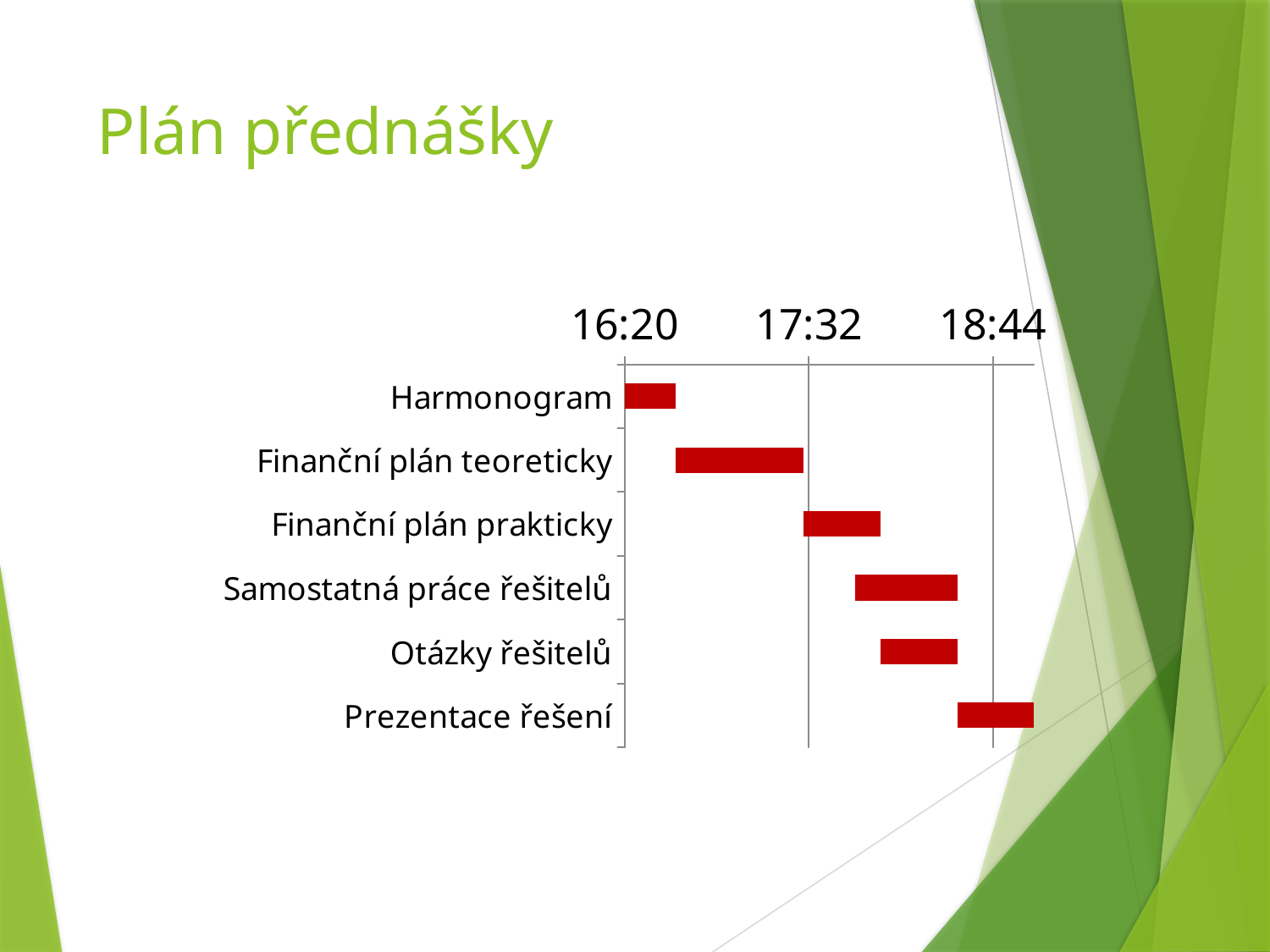
Does the bar for Prezentace řešení end before or after 18:44? after Which activity is listed first (at the top) on the chart? Harmonogram What kind of chart is shown on the slide? bar chart How many time labels are shown on the horizontal axis? 3 How many categories (activities) are listed on the chart? 6 Does the bar for Samostatná práce řešitelů start before or after 17:32? after Does the bar for Otázky řešitelů end before or after 18:44? before Which activity has the longest bar on the chart? Finanční plán teoreticky Which activity has the shortest bar on the chart? Harmonogram What is the title of the slide containing the chart? Plán přednášky Which bar is longer, the one for Finanční plán teoreticky or the one for Finanční plán prakticky? Finanční plán teoreticky